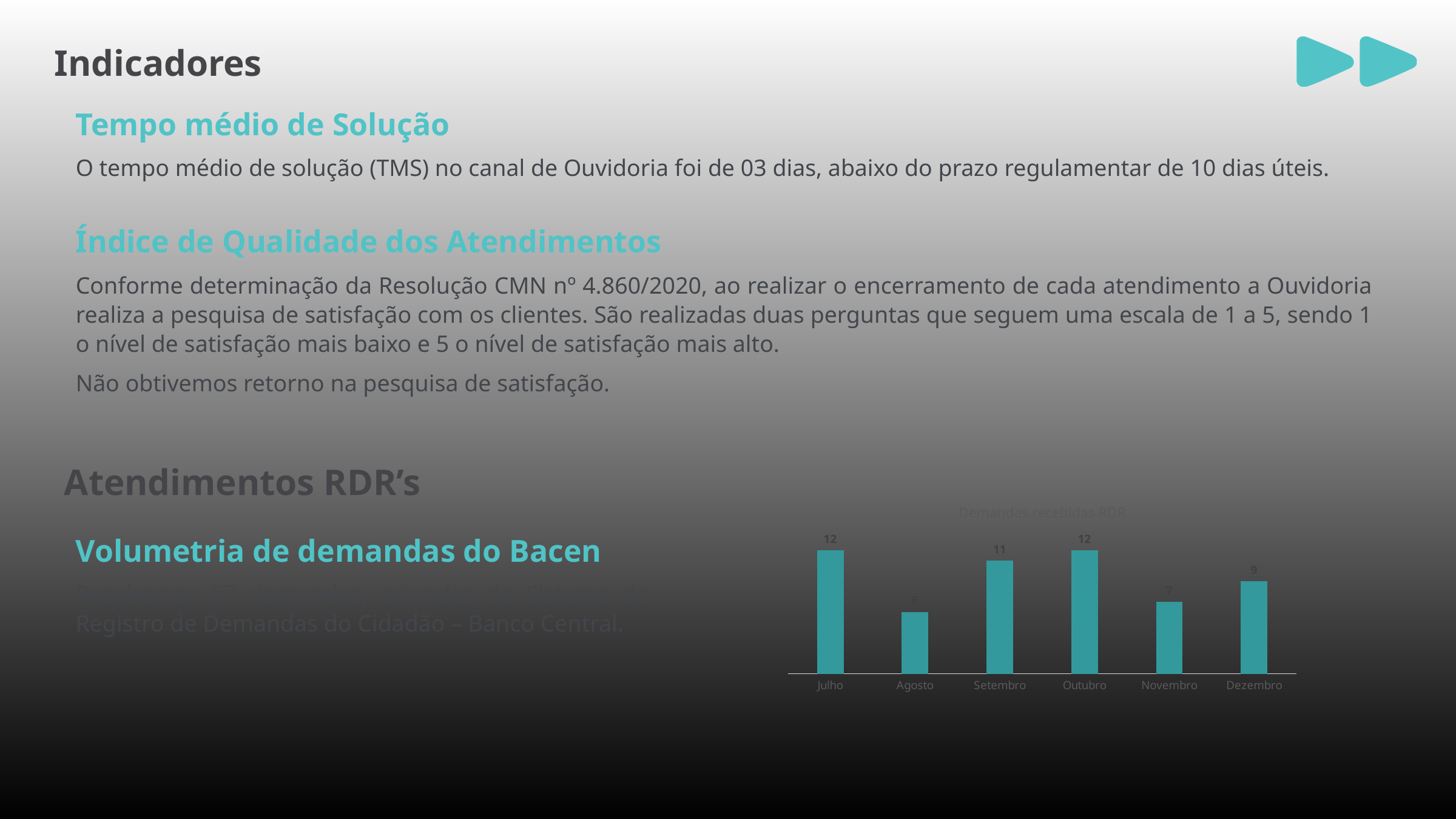
What kind of chart is the Demandas recebidas RDR chart? Bar chart Which is larger in the Demandas recebidas RDR chart, Setembro or Dezembro? Setembro What is the value for Novembro in the Demandas recebidas RDR chart? 7 What is the value for Outubro in the Demandas recebidas RDR chart? 12 What is the title of the chart on the slide? Demandas recebidas RDR What is the difference between the values for Julho and Setembro in the Demandas recebidas RDR chart? 1 What is the value for Dezembro in the Demandas recebidas RDR chart? 9 What is the value for Setembro in the Demandas recebidas RDR chart? 11 Which month has the lowest value in the Demandas recebidas RDR chart? Agosto What is the difference between the values for Outubro and Dezembro in the Demandas recebidas RDR chart? 3 How many months are shown in the Demandas recebidas RDR chart? 6 What is the value for Julho in the Demandas recebidas RDR chart? 12